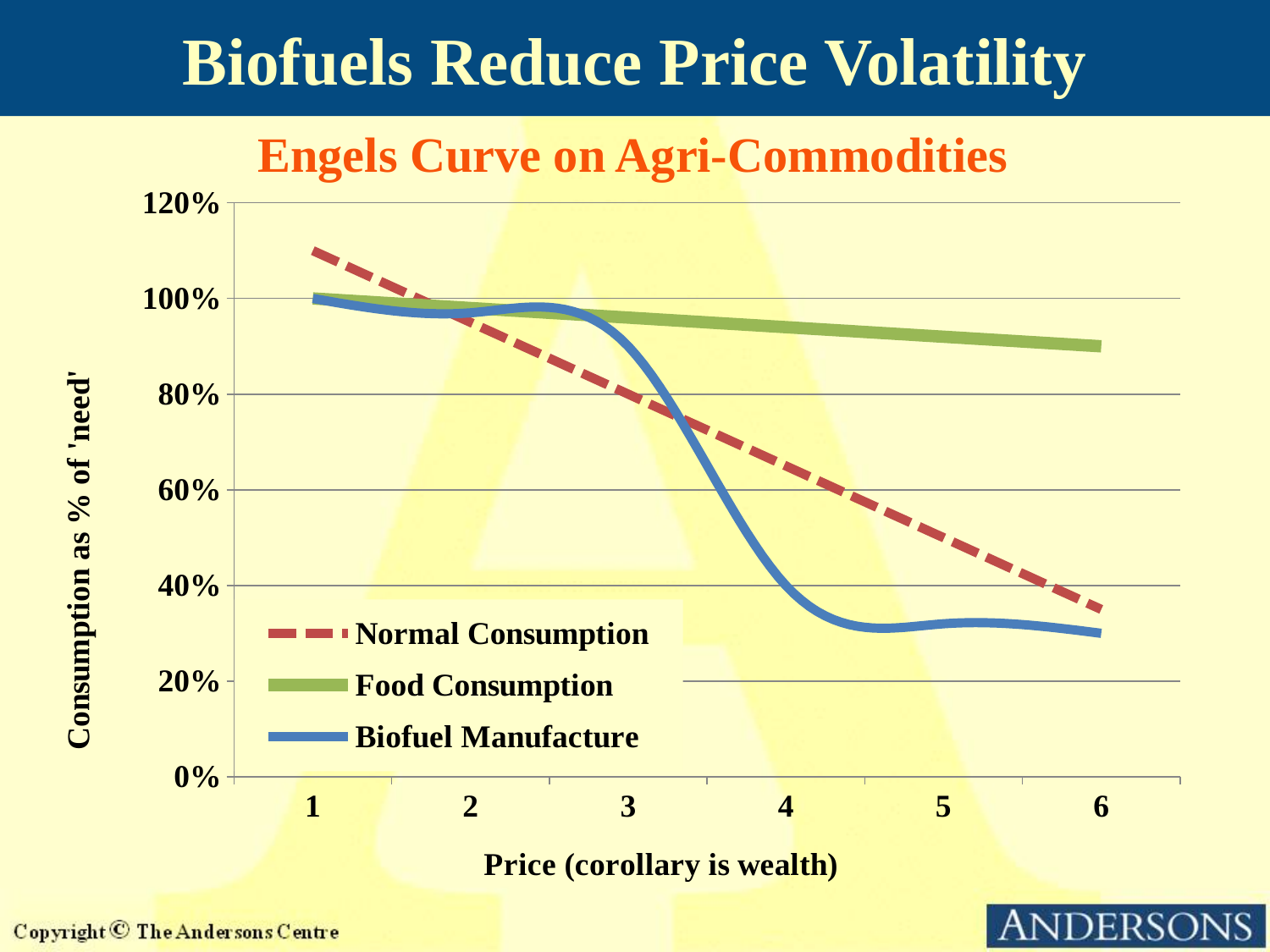
At price 6, which is larger: Food Consumption or Biofuel Manufacture? Food Consumption How many price levels are marked along the x axis? 6 What is the title of the chart? Engels Curve on Agri-Commodities Is the value for Normal Consumption at price 1 greater or less than 100%? greater How many series does the legend list? 3 Does the Biofuel Manufacture line rise or fall as price increases from 1 to 6? fall Is the value for Biofuel Manufacture at price 5 greater or less than 40%? less Does the Food Consumption line rise or fall as price increases from 1 to 6? fall At price 5, which is larger: Normal Consumption or Biofuel Manufacture? Normal Consumption What kind of chart is shown on the slide? line chart Is the value for Food Consumption at price 6 greater or less than 80%? greater